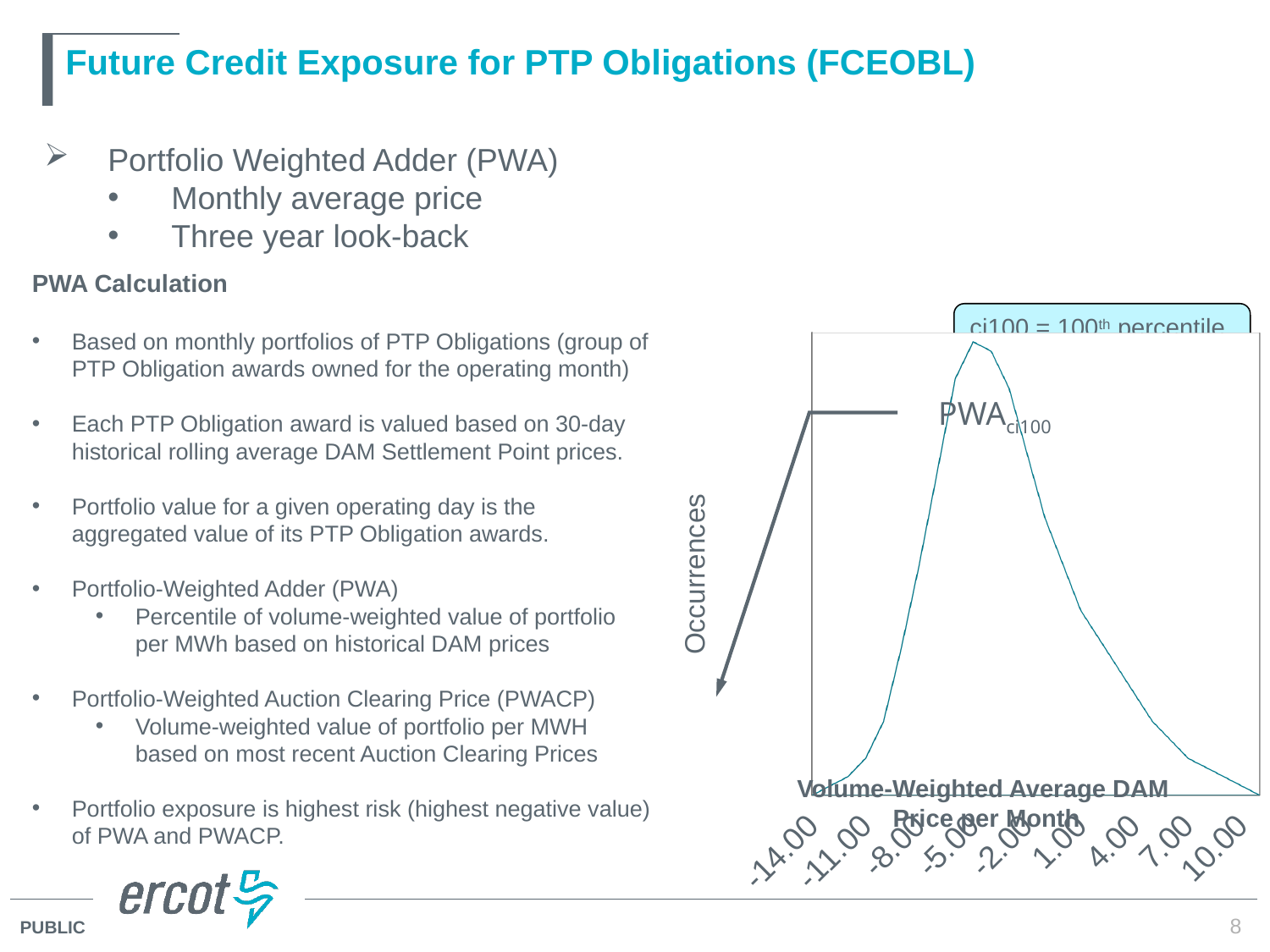
Do the occurrences rise or fall along the x axis between 1.00 and 10.00? fall How many tick labels are shown on the horizontal axis of the chart? 9 Which has fewer occurrences on the chart, a price of -14.00 or a price of 1.00? -14.00 What is the title of the horizontal axis of the chart? Volume-Weighted Average DAM Price per Month Which has more occurrences on the chart, a price of -11.00 or a price of -2.00? -2.00 What is the lowest price value labelled on the horizontal axis of the chart? -14.00 Which has more occurrences on the chart, a price of -5.00 or a price of 10.00? -5.00 Do the occurrences rise or fall along the x axis between -14.00 and -5.00? rise What is the label on the vertical axis of the chart? Occurrences What kind of chart is shown on the slide? line chart